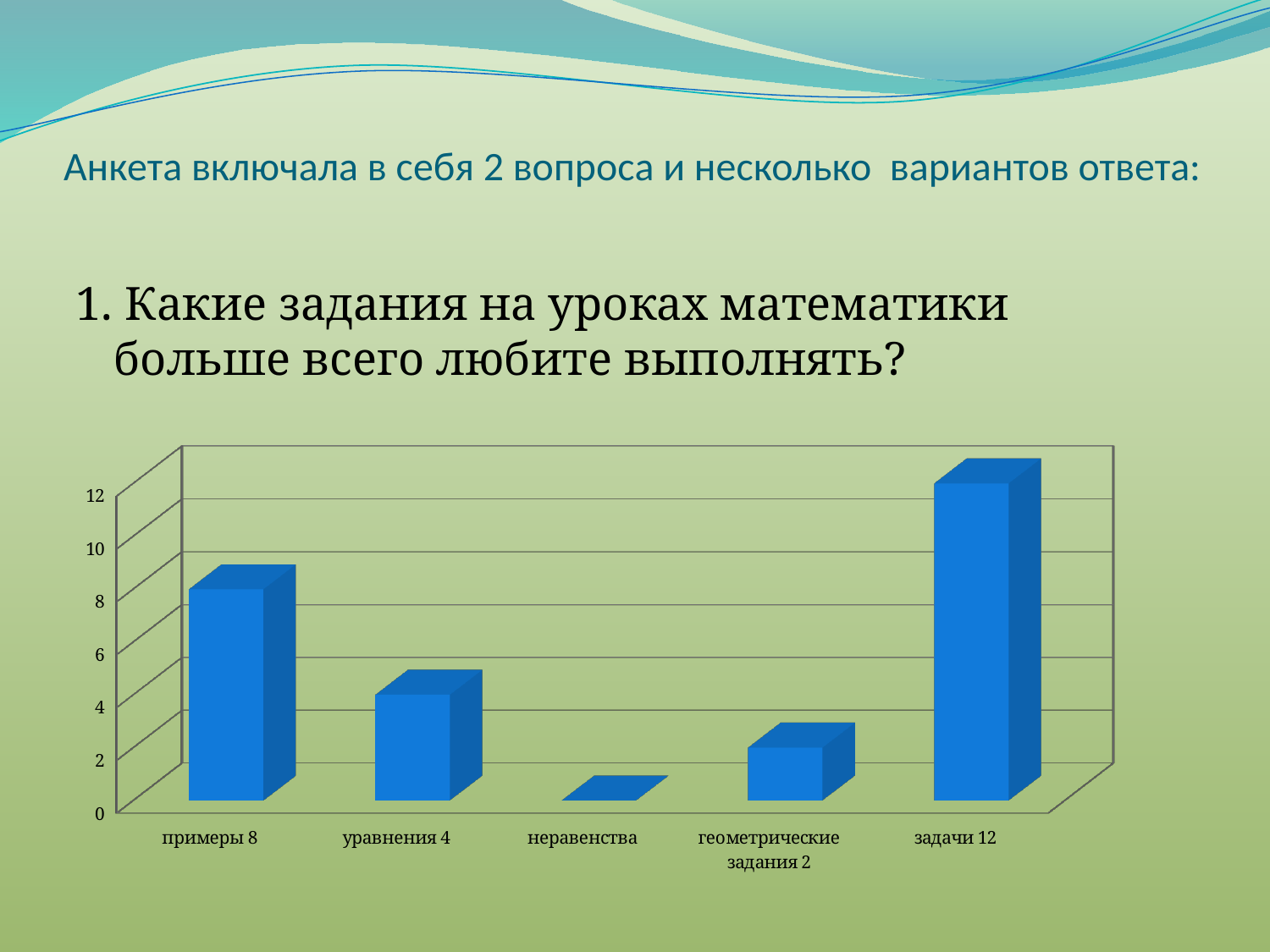
What kind of chart is shown on the slide? bar chart Which is larger, the value for уравнения or the value for геометрические задания? уравнения How many categories are shown on the x axis of the chart? 5 What value is given for геометрические задания in the chart? 2 Which category has the lowest bar in the chart? неравенства What colour are the bars in the chart? blue Is the value for неравенства greater or less than 2? less Which category has the highest bar in the chart? задачи What is the difference between the values for уравнения and геометрические задания? 2 What is the difference between the values for задачи and примеры? 4 What value is given for задачи in the chart? 12 What value is given for примеры in the chart? 8